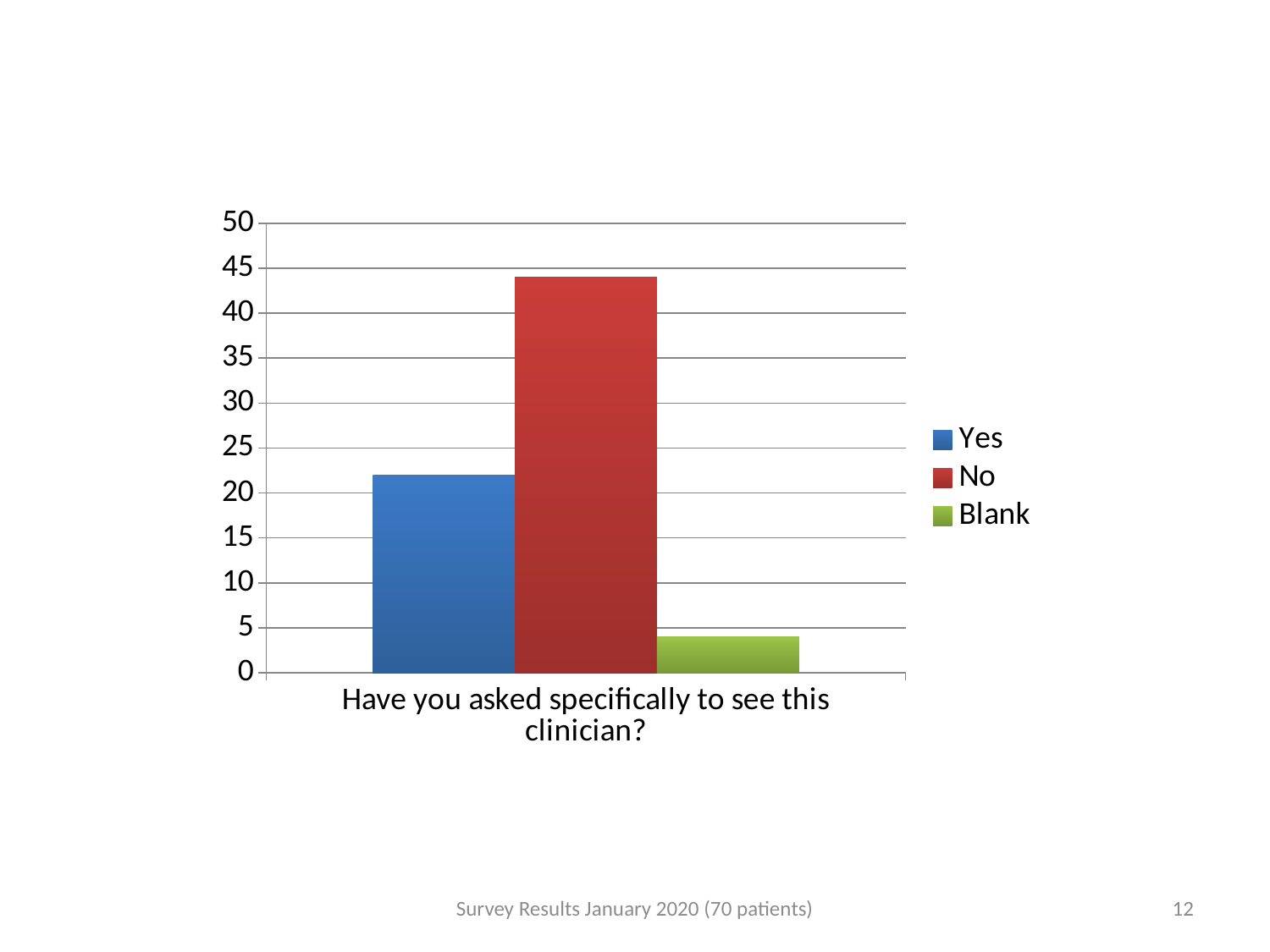
Which series has the highest value? No Which is larger, the value for Yes or the value for No? No Is the value for Yes greater or less than 25? less What kind of chart is shown on the slide? bar chart Is the value for No greater or less than 40? greater Which series has the lowest value? Blank Is the value for No greater or less than 45? less How many series does the legend list? 3 What colour is the bar for the No series? red What is the category label shown on the x axis? Have you asked specifically to see this clinician?